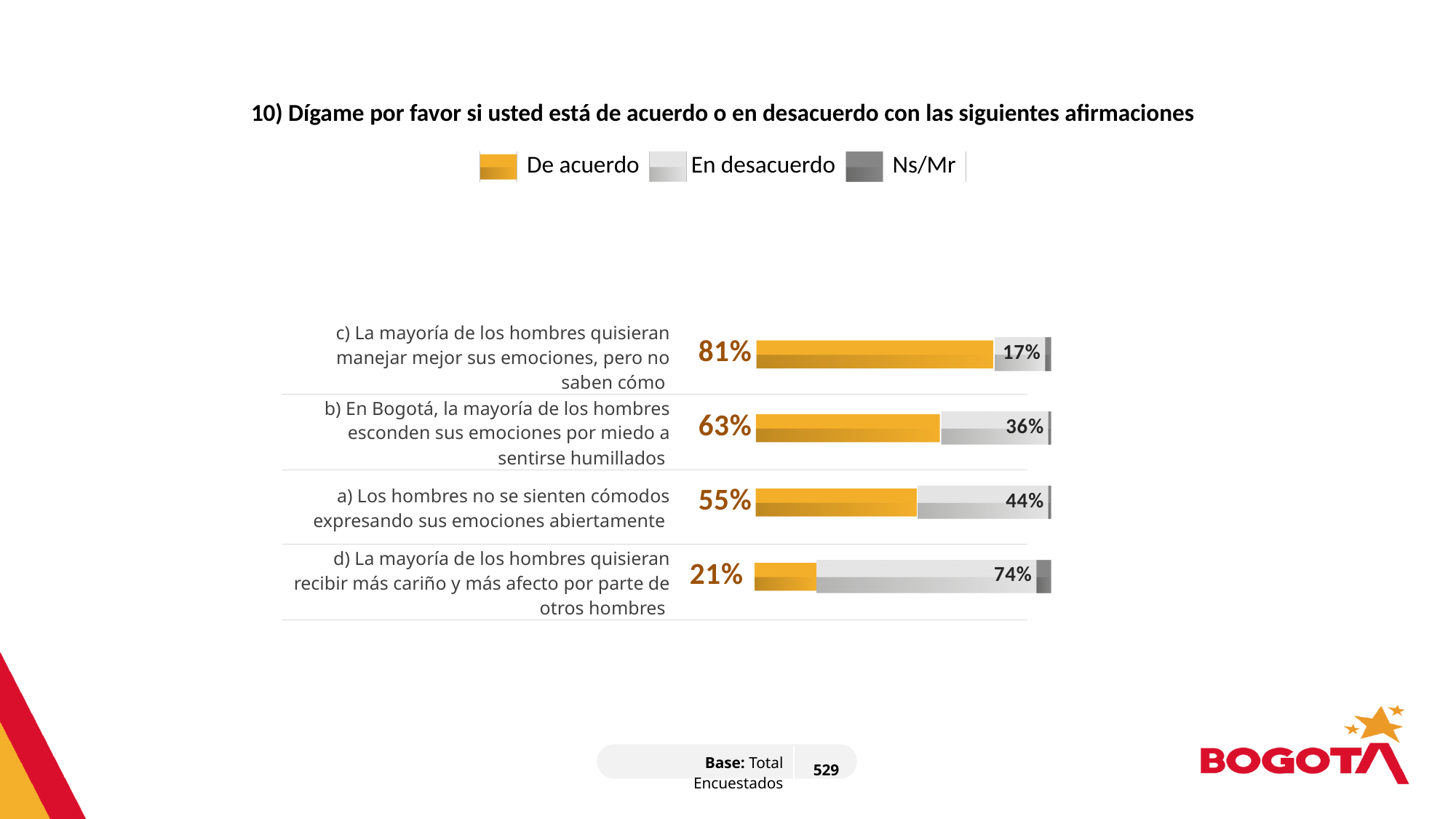
What type of chart is shown on the slide? Stacked bar chart What percentage of respondents agree (De acuerdo) with statement c) "La mayoría de los hombres quisieran manejar mejor sus emociones, pero no saben cómo"? 81% Which statement has the lowest De acuerdo percentage? d) La mayoría de los hombres quisieran recibir más cariño y más afecto por parte de otros hombres Which colour represents the De acuerdo series in the chart? Orange Which is larger for statement a): the De acuerdo share or the En desacuerdo share? De acuerdo How many series does the legend list? 3 What is the difference in De acuerdo percentage between statement c) and statement b)? 18 percentage points How many statements are shown in the chart? 4 What is the De acuerdo value for statement a) "Los hombres no se sienten cómodos expresando sus emociones abiertamente"? 55% What percentage of respondents disagree (En desacuerdo) with statement d) "La mayoría de los hombres quisieran recibir más cariño y más afecto por parte de otros hombres"? 74% Which statement has the highest De acuerdo percentage? c) La mayoría de los hombres quisieran manejar mejor sus emociones, pero no saben cómo What is the En desacuerdo value for statement b) "En Bogotá, la mayoría de los hombres esconden sus emociones por miedo a sentirse humillados"? 36%